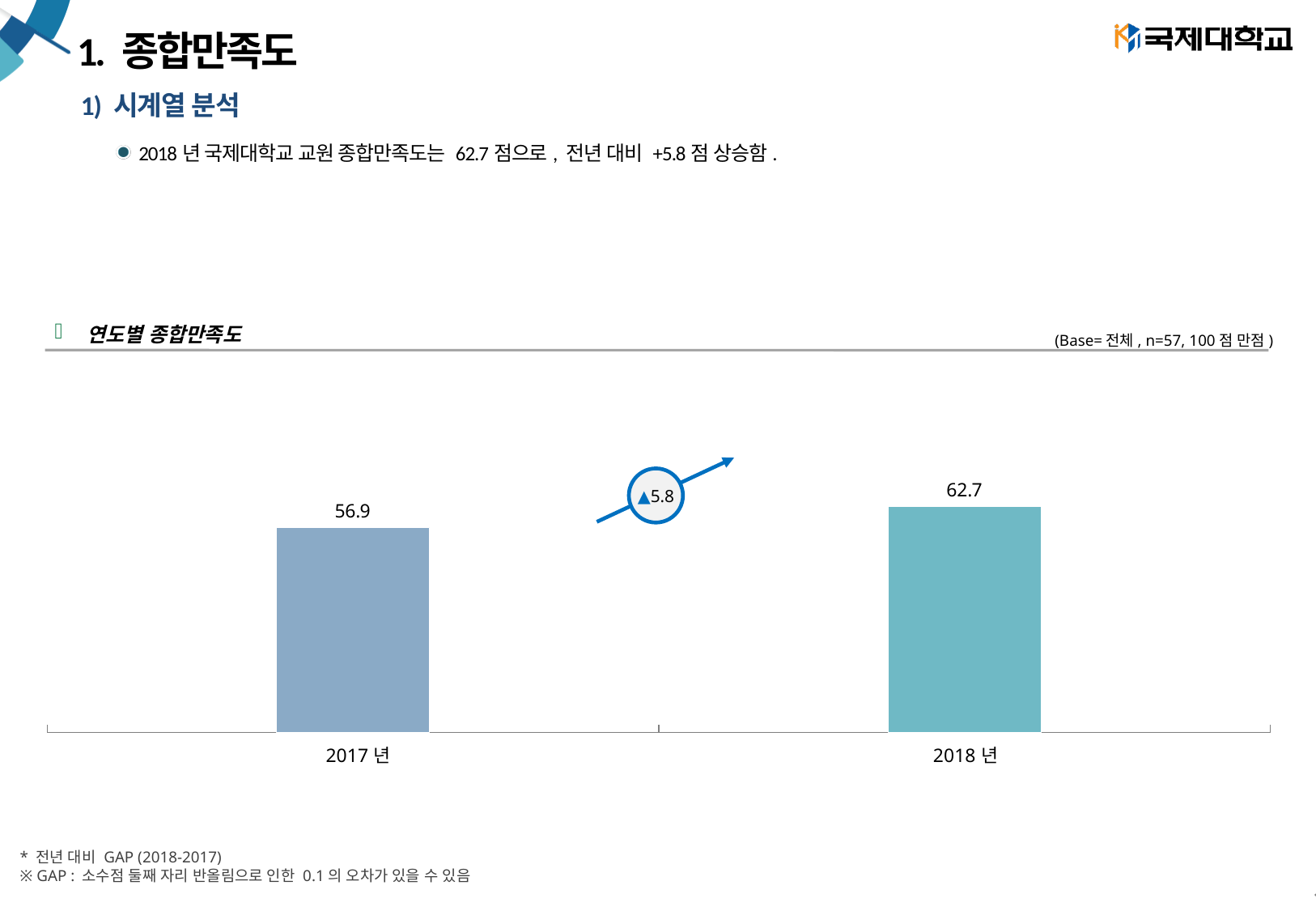
Do the values rise or fall from 2017년 to 2018년 in the 연도별 종합만족도 chart? rise Which year has the lower value in the 연도별 종합만족도 chart? 2017년 Is the value for 2017년 larger or smaller than the value for 2018년? smaller What change value is shown in the circle between the two bars? ▲5.8 What is the value for 2017년 in the 연도별 종합만족도 chart? 56.9 Which year has the higher value in the 연도별 종합만족도 chart? 2018년 What is the difference between the 2018년 and 2017년 values in the 연도별 종합만족도 chart? 5.8 What kind of chart is the 연도별 종합만족도 chart? bar chart How many bars are shown in the 연도별 종합만족도 chart? 2 What is the value for 2018년 in the 연도별 종합만족도 chart? 62.7 What is the title of the chart on the slide? 연도별 종합만족도